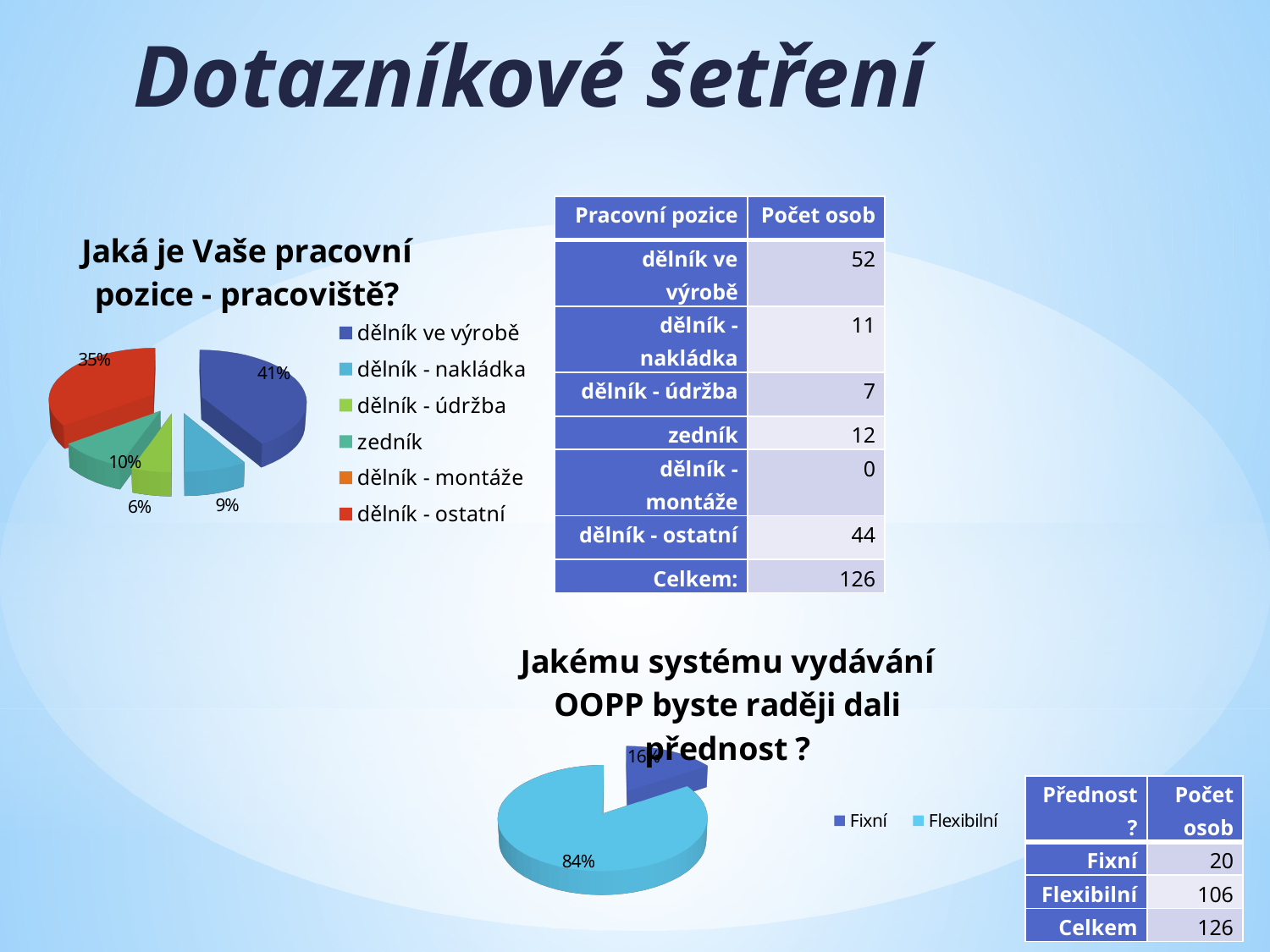
In the chart "Jaká je Vaše pracovní pozice - pracoviště?", what share is shown for dělník ve výrobě? 41% In the chart "Jaká je Vaše pracovní pozice - pracoviště?", which is larger, the share for zedník or the share for dělník - nakládka? zedník In the chart "Jakému systému vydávání OOPP byste raději dali přednost?", which category has the larger slice? Flexibilní In the chart "Jaká je Vaše pracovní pozice - pracoviště?", what share is shown for dělník - ostatní? 35% In the chart "Jaká je Vaše pracovní pozice - pracoviště?", how many entries does the legend list? 6 In the chart "Jakému systému vydávání OOPP byste raději dali přednost?", how many entries does the legend list? 2 In the chart "Jakému systému vydávání OOPP byste raději dali přednost?", what share is shown for Flexibilní? 84% In the chart "Jaká je Vaše pracovní pozice - pracoviště?", which category has the largest slice? dělník ve výrobě In the chart "Jaká je Vaše pracovní pozice - pracoviště?", what is the difference between the shares for dělník ve výrobě and dělník - ostatní? 6% What type of chart is used for "Jaká je Vaše pracovní pozice - pracoviště?"? pie chart